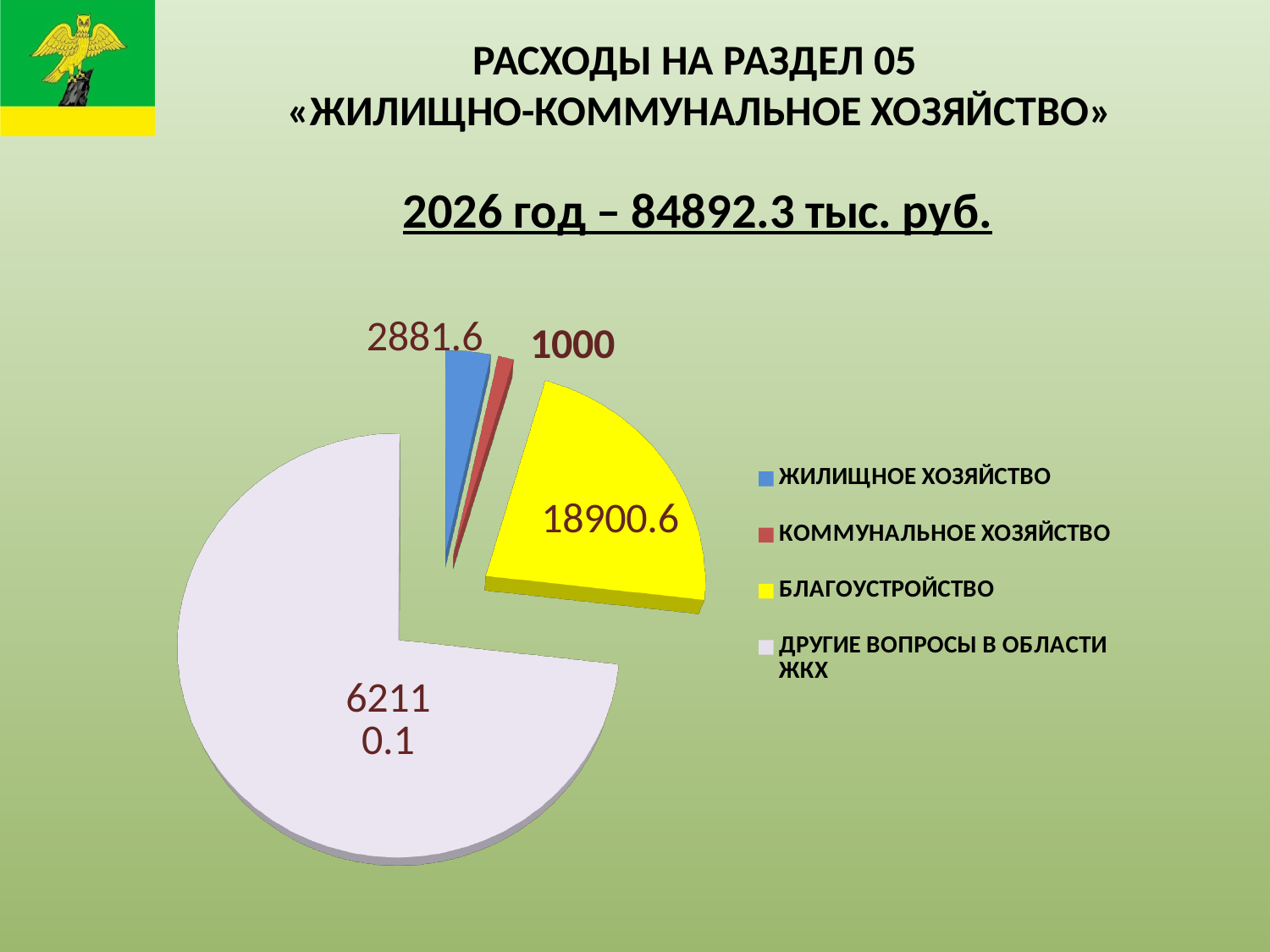
What is the value for КОММУНАЛЬНОЕ ХОЗЯЙСТВО? 1000 What is the value for ЖИЛИЩНОЕ ХОЗЯЙСТВО? 2881.6 Which category has the smallest slice of the pie? КОММУНАЛЬНОЕ ХОЗЯЙСТВО Which is larger, the value for БЛАГОУСТРОЙСТВО or the value for ЖИЛИЩНОЕ ХОЗЯЙСТВО? БЛАГОУСТРОЙСТВО What is the difference between the values for ЖИЛИЩНОЕ ХОЗЯЙСТВО and КОММУНАЛЬНОЕ ХОЗЯЙСТВО? 1881.6 What type of chart is shown on the slide? pie chart How many categories does the pie chart have? 4 What colour is the slice for БЛАГОУСТРОЙСТВО? yellow What is the difference between the values for БЛАГОУСТРОЙСТВО and ЖИЛИЩНОЕ ХОЗЯЙСТВО? 16019 Which category has the largest slice of the pie? ДРУГИЕ ВОПРОСЫ В ОБЛАСТИ ЖКХ What is the value for БЛАГОУСТРОЙСТВО? 18900.6 What is the value for ДРУГИЕ ВОПРОСЫ В ОБЛАСТИ ЖКХ? 62110.1